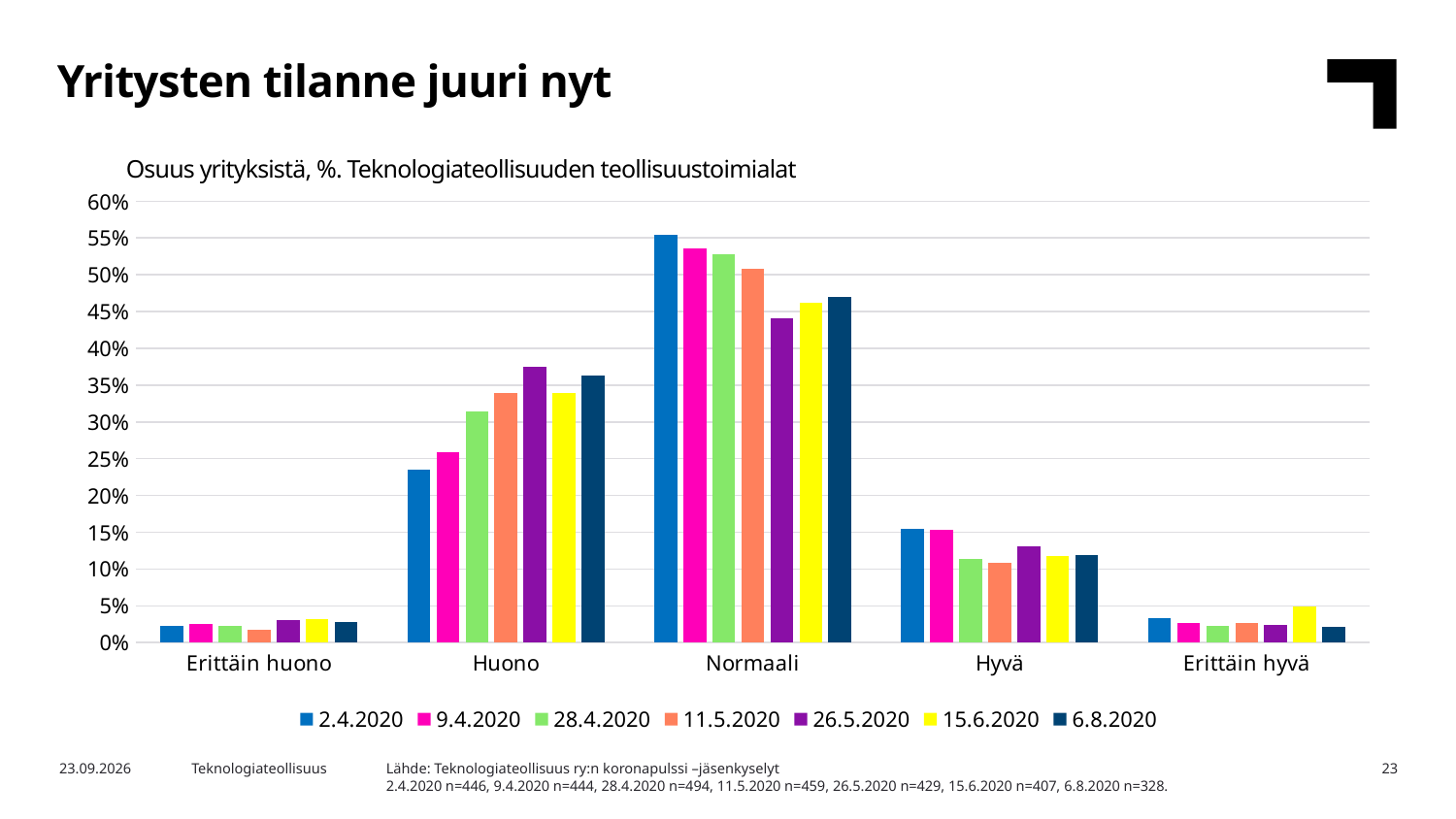
Which is larger: the value for Normaali in the 2.4.2020 series or in the 6.8.2020 series? 2.4.2020 Which category has the highest value for the 2.4.2020 series? Normaali How many categories are shown on the x axis of the chart? 5 Is the value for Hyvä in the 28.4.2020 series greater or less than 15%? less What kind of chart is shown on the slide? bar chart Is the value for Huono in the 26.5.2020 series greater or less than 35%? greater Is the value for Normaali in the 2.4.2020 series greater or less than 50%? greater Within the Normaali category, which series has the lowest value? 26.5.2020 For the Huono category, do the values rise or fall from the 2.4.2020 series to the 26.5.2020 series? rise How many series does the chart's legend list? 7 Which is larger: the value for Huono in the 2.4.2020 series or in the 6.8.2020 series? 6.8.2020 What is the title of the slide containing the chart? Yritysten tilanne juuri nyt